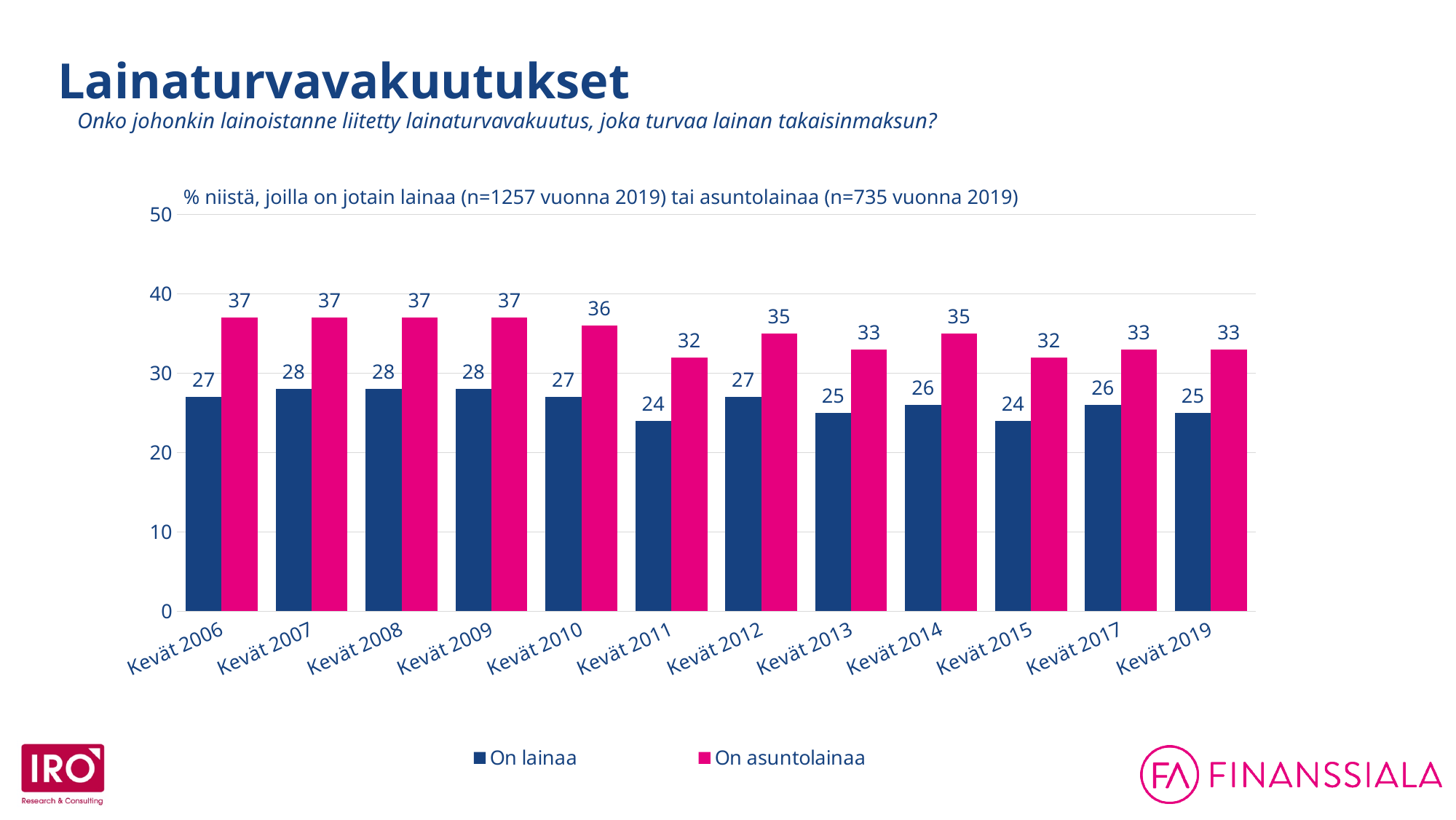
Which category has the lowest value for "On asuntolainaa"? Kevät 2011 and Kevät 2015 (32) What is the value for "On asuntolainaa" in Kevät 2019? 33 How many series does the legend list? 2 Which is larger in Kevät 2014: "On lainaa" or "On asuntolainaa"? On asuntolainaa How many categories are shown on the x axis? 12 What colour are the bars for "On asuntolainaa"? Pink What is the difference between "On asuntolainaa" and "On lainaa" in Kevät 2006? 10 Does the value for "On asuntolainaa" rise or fall from Kevät 2009 to Kevät 2011? Fall What kind of chart is shown on the slide? Bar chart What is the value for "On lainaa" in Kevät 2011? 24 What is the value for "On asuntolainaa" in Kevät 2010? 36 Is the value for "On asuntolainaa" in Kevät 2007 greater or less than 30? greater